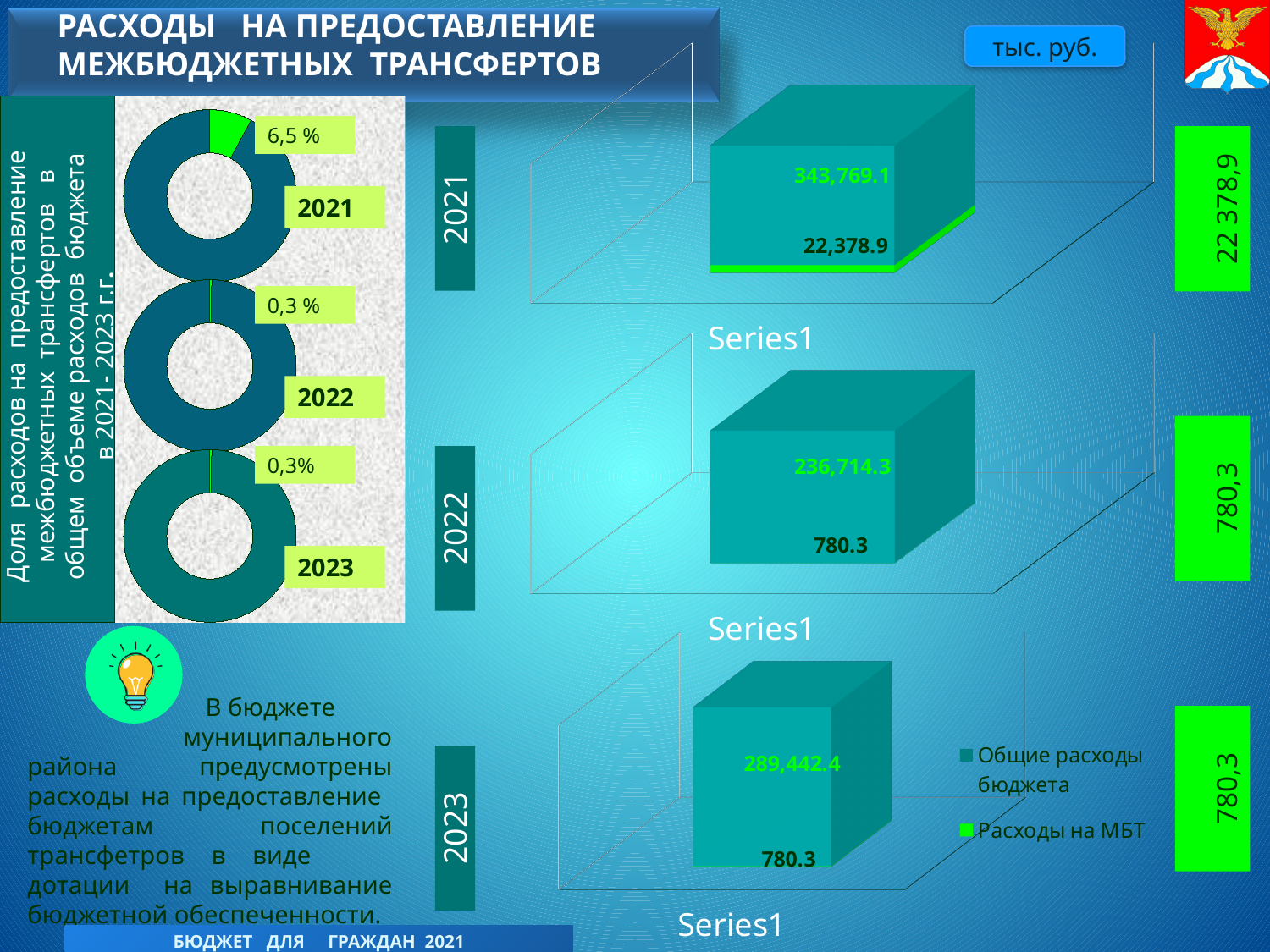
On the 2023 bar chart, what is the value labelled for Общие расходы бюджета? 289,442.4 On the donut chart for 2022, what share is shown for the highlighted slice? 0,3 % On the donut chart for 2021, what share is shown for the highlighted slice? 6,5 % How many series does the legend of the bar charts list? 2 Across the three bar charts for 2021, 2022 and 2023, which year has the lowest value for Общие расходы бюджета? 2022 On the 2023 bar chart, what is the value labelled for Расходы на МБТ? 780.3 Which is larger: Расходы на МБТ in 2021 or Расходы на МБТ in 2022? 2021 On the 2022 bar chart, what is the value labelled for Общие расходы бюджета? 236,714.3 On the 2021 bar chart, what is the difference between Общие расходы бюджета and Расходы на МБТ? 321,390.2 Across the three bar charts for 2021, 2022 and 2023, which year has the highest value for Общие расходы бюджета? 2021 On the 2021 bar chart, what is the value labelled for Общие расходы бюджета? 343,769.1 On the 2021 bar chart, what is the value labelled for Расходы на МБТ? 22,378.9